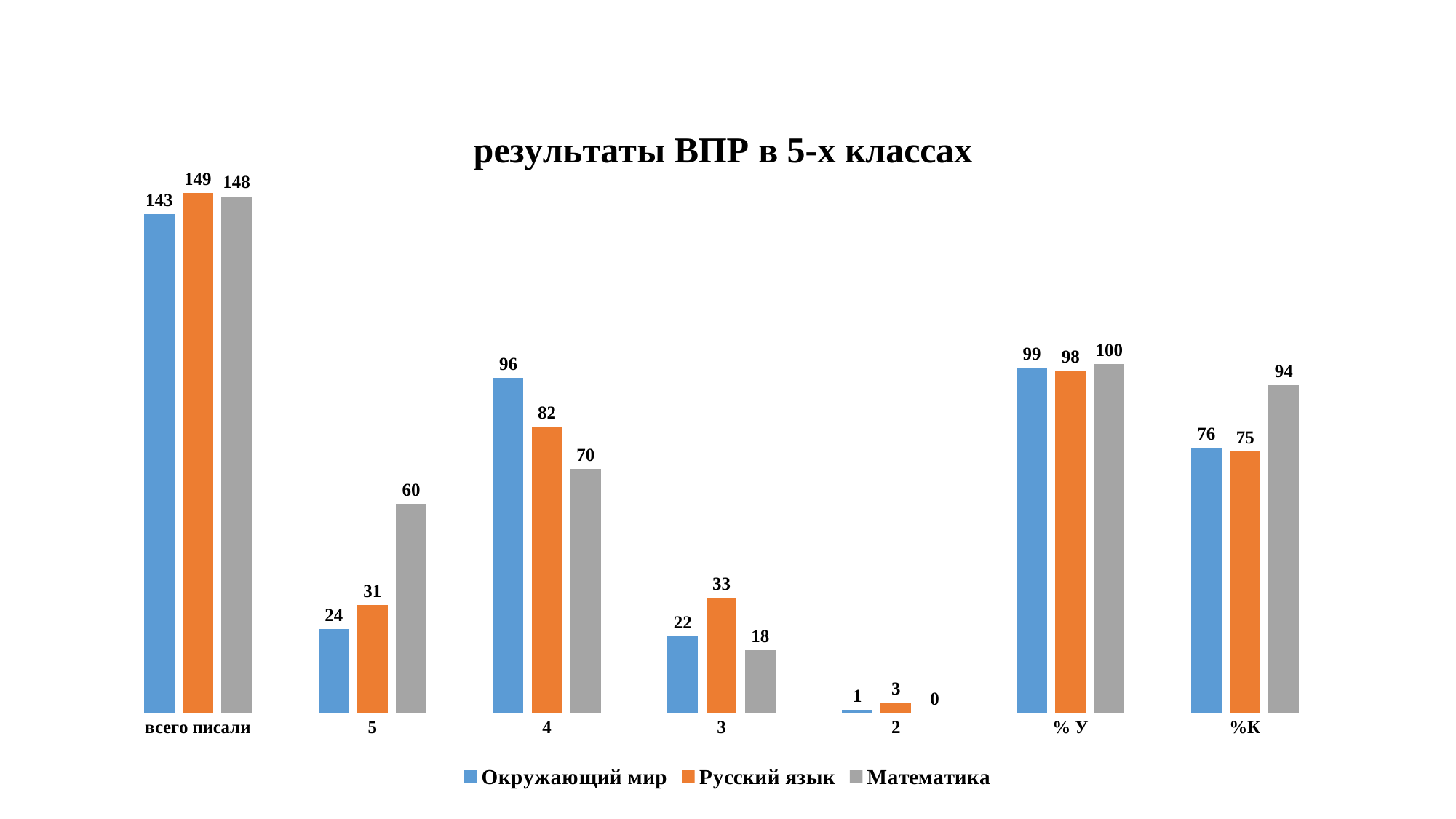
Which series has the highest value in the category 3? Русский язык What kind of chart is shown on the slide? Bar chart How many categories are shown on the x axis? 7 Which is larger in the category 4: the value for Русский язык or the value for Математика? Русский язык What is the title of the chart? результаты ВПР в 5-х классах What is the value for Окружающий мир in the category 4? 96 What is the value for Русский язык in the category всего писали? 149 What is the value for Математика in the category %К? 94 What is the difference between the Математика and Окружающий мир values in the category 5? 36 What is the value for Математика in the category 5? 60 How many series does the legend list? 3 Which series has the lowest value in the category 2? Математика